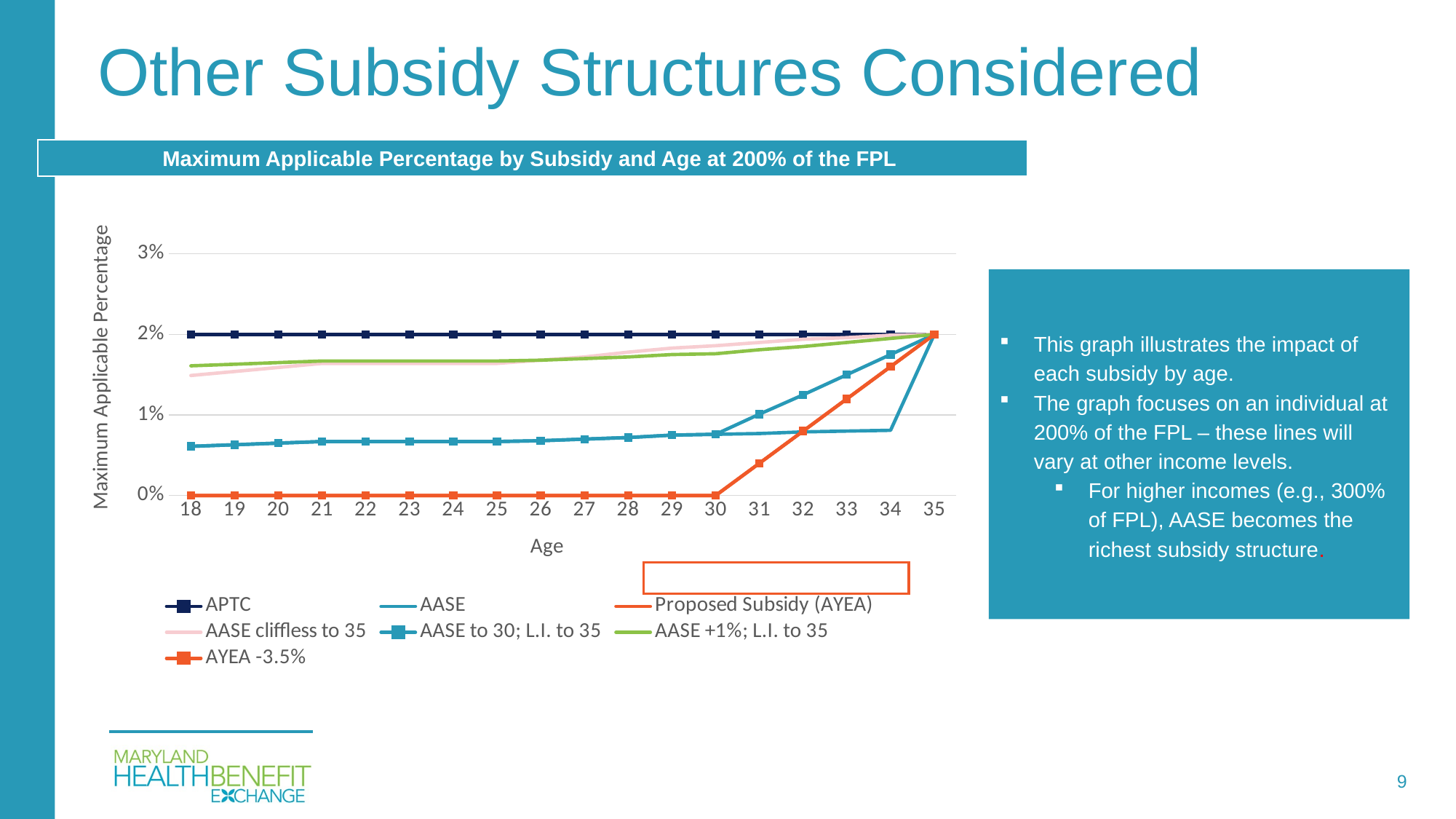
At age 18, which is larger: APTC or AASE? APTC How many series does the chart legend list? 7 What is the value of the AYEA -3.5% line at age 30? 0% What is the value of the Proposed Subsidy (AYEA) line at age 20? 0% How many age points are plotted along the x axis? 18 What kind of chart is shown on the slide? line chart Does the AASE to 30; L.I. to 35 line rise or fall between age 30 and age 35? rise Which series has the highest value at age 18? APTC What is the title of the chart's x axis? Age What is the maximum applicable percentage for APTC at age 25? 2% Is the value for AASE cliffless to 35 at age 18 greater or less than 1%? greater Is the value for AASE at age 18 greater or less than 1%? less